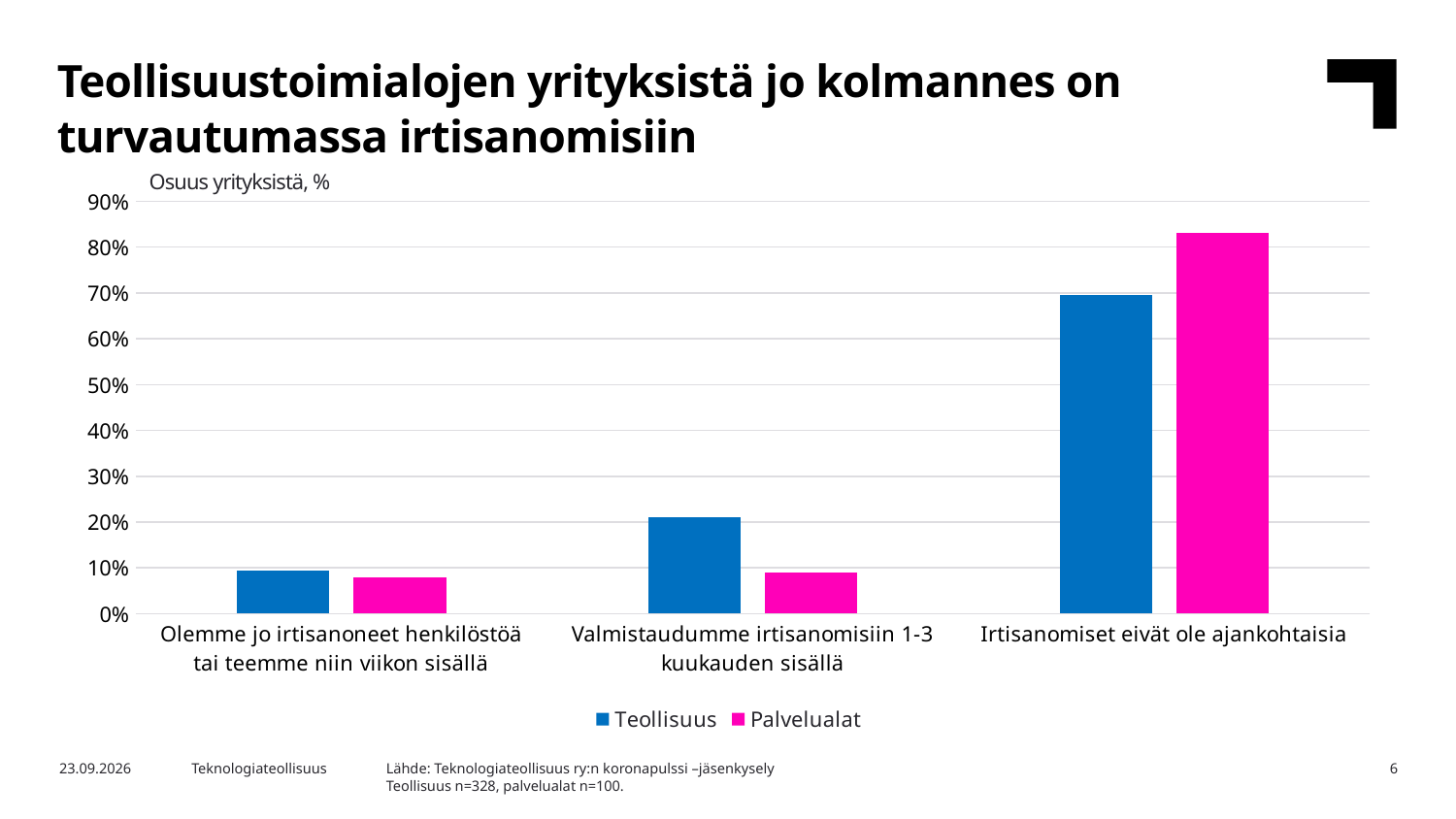
For the category 'Valmistaudumme irtisanomisiin 1-3 kuukauden sisällä', which series has the larger value, Teollisuus or Palvelualat? Teollisuus How many categories are shown on the x axis? 3 How many series does the legend list? 2 Is the Teollisuus value for 'Irtisanomiset eivät ole ajankohtaisia' greater or less than 60%? greater Is the Palvelualat value for 'Irtisanomiset eivät ole ajankohtaisia' greater or less than 80%? greater Which category has the highest value for Teollisuus? Irtisanomiset eivät ole ajankohtaisia Which category has the lowest value for Teollisuus? Olemme jo irtisanoneet henkilöstöä tai teemme niin viikon sisällä Which category has the highest value for Palvelualat? Irtisanomiset eivät ole ajankohtaisia What is the axis label shown above the y axis of the chart? Osuus yrityksistä, % What kind of chart is shown on the slide? bar chart Is the Palvelualat value for 'Valmistaudumme irtisanomisiin 1-3 kuukauden sisällä' greater or less than 20%? less For the category 'Irtisanomiset eivät ole ajankohtaisia', which series has the larger value, Teollisuus or Palvelualat? Palvelualat